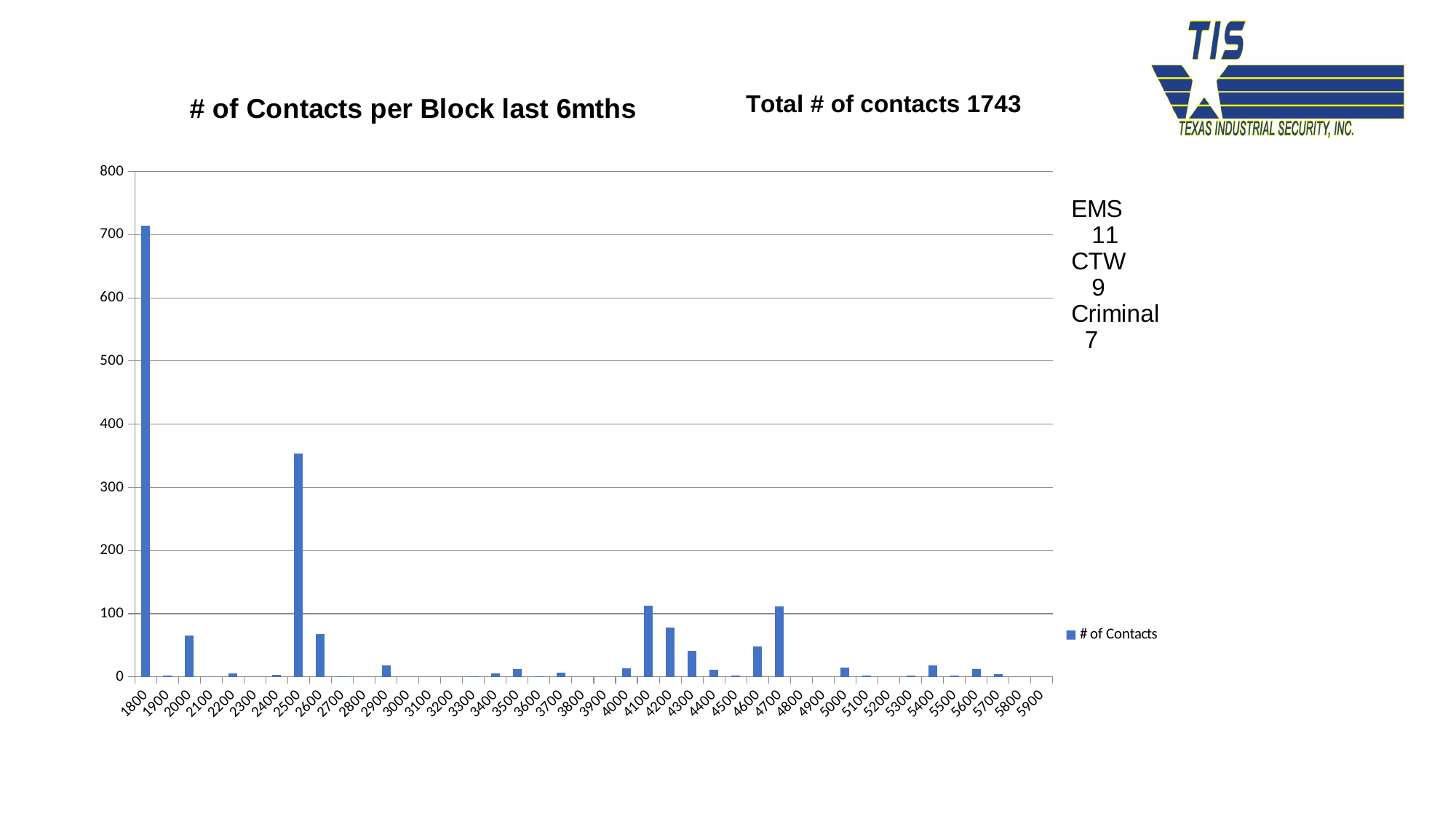
Is the value for block 4200 greater or less than 100? less Which block has more contacts, 4100 or 4200? 4100 Is the value for block 2500 greater or less than 400? less Is the value for block 1800 greater or less than 600? greater Which block has the highest number of contacts? 1800 What is the title of the chart? # of Contacts per Block last 6mths How many series does the legend list? 1 What is the legend entry for the series? # of Contacts What kind of chart is shown on the slide? bar chart Which block has more contacts, 1800 or 2500? 1800 Which block has more contacts, 2000 or 4300? 2000